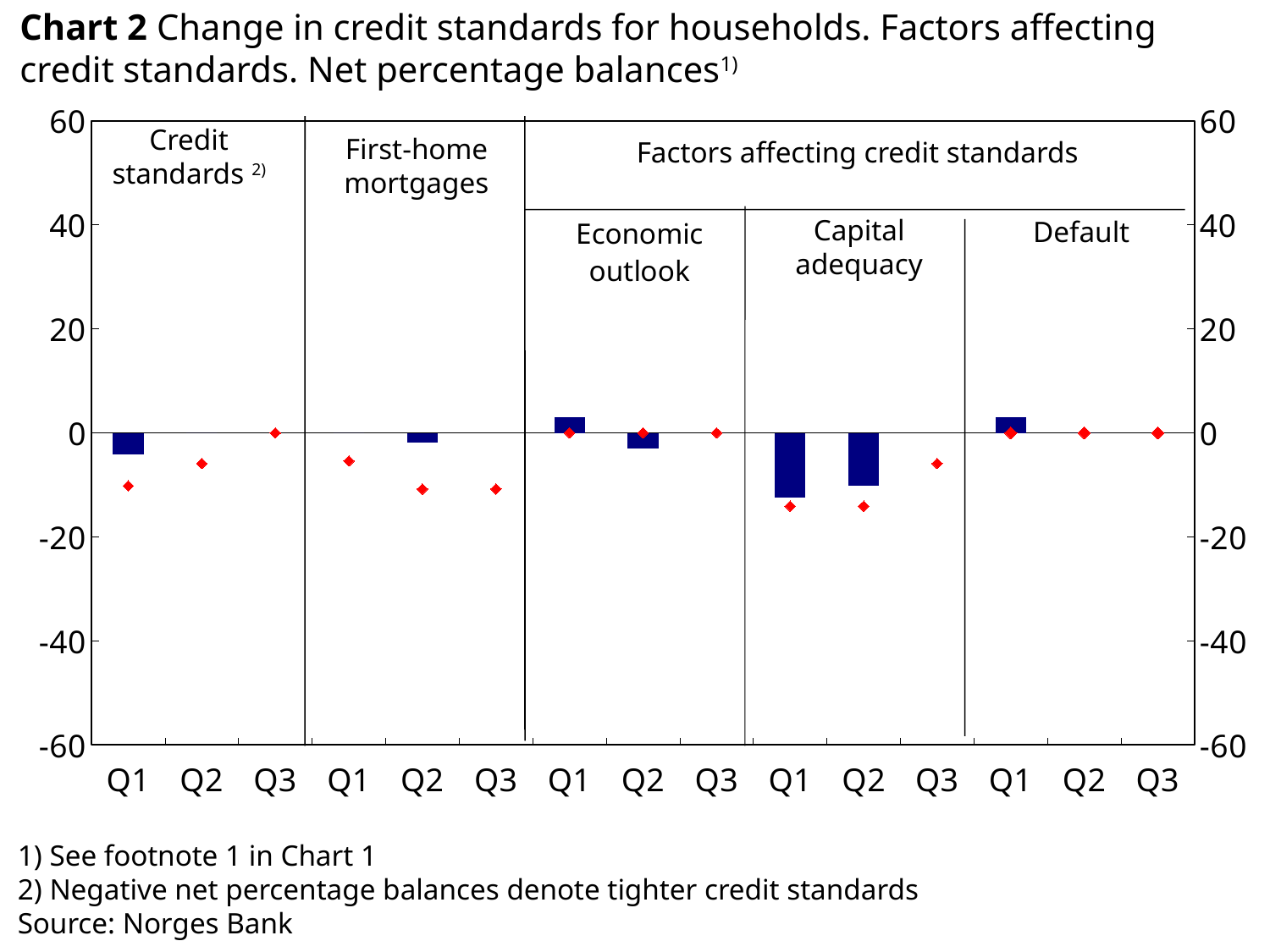
What is the source given for the chart? Norges Bank How many quarters (Q1, Q2, Q3) are shown in each panel of the chart? 3 Is the bar for Q1 under Economic outlook greater or less than 0? greater Is the bar for Q1 under Capital adequacy greater or less than -20? greater Is the bar for Q1 under Credit standards greater or less than 0? less Which is larger, the Q1 bar under Economic outlook or the Q1 bar under Capital adequacy? Q1 under Economic outlook What is the highest value shown on the vertical axis? 60 Which panel of the chart contains the lowest bar? Capital adequacy What kind of chart is shown on the slide? bar chart How many factors affecting credit standards are shown in the chart? 3